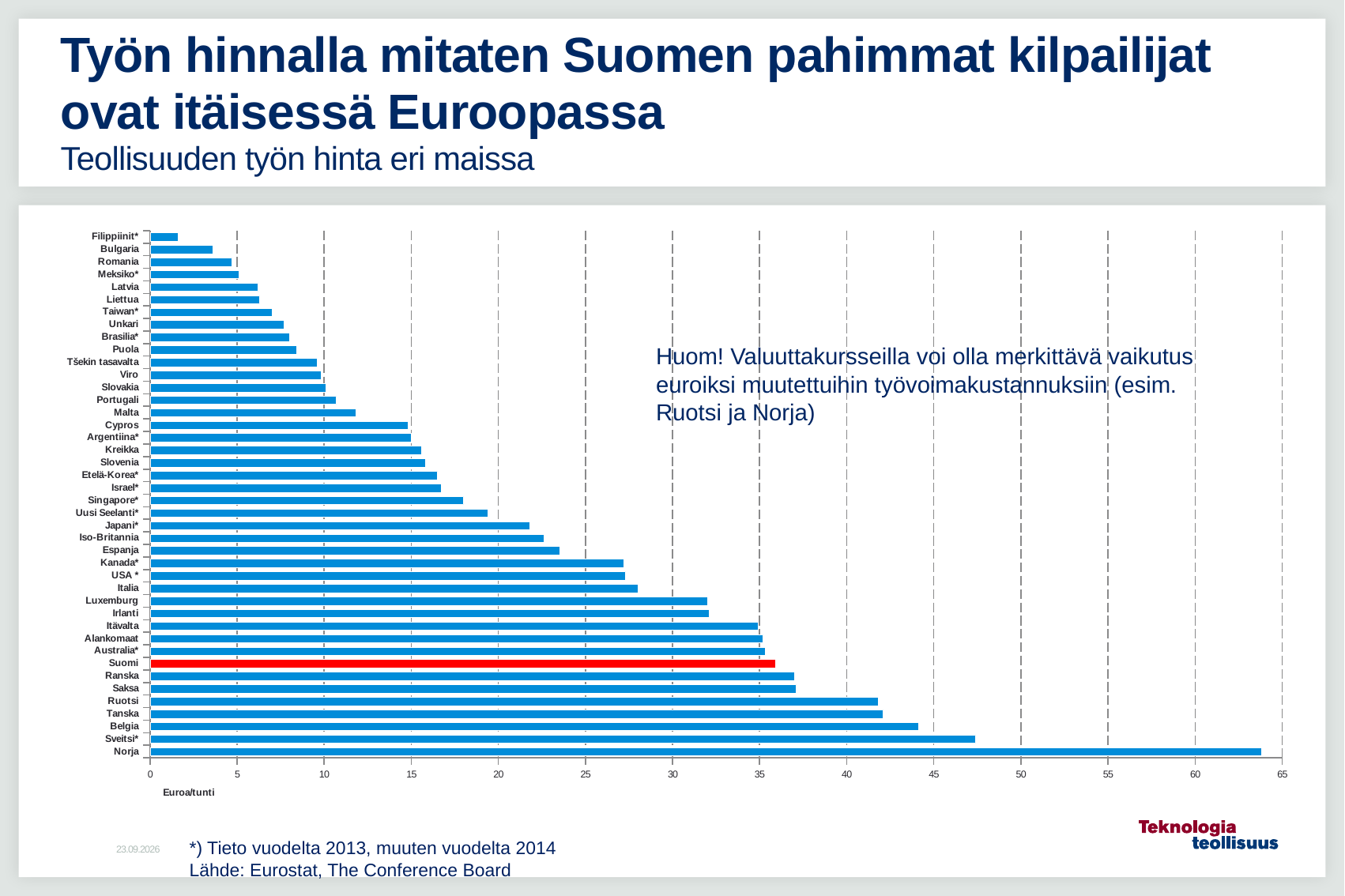
Is the value for Belgia greater or less than 40? greater Which bar is highlighted in red in the chart? Suomi Is the value for Bulgaria greater or less than 5? less How many countries are listed in the chart? 42 Which country has the highest value in the chart? Norja What kind of chart is shown on the slide? bar chart Is the value for Suomi greater or less than 40? less Which country has the lowest value in the chart? Filippiinit* What unit is shown on the x axis of the chart? Euroa/tunti Which has the larger value, Italia or Espanja? Italia